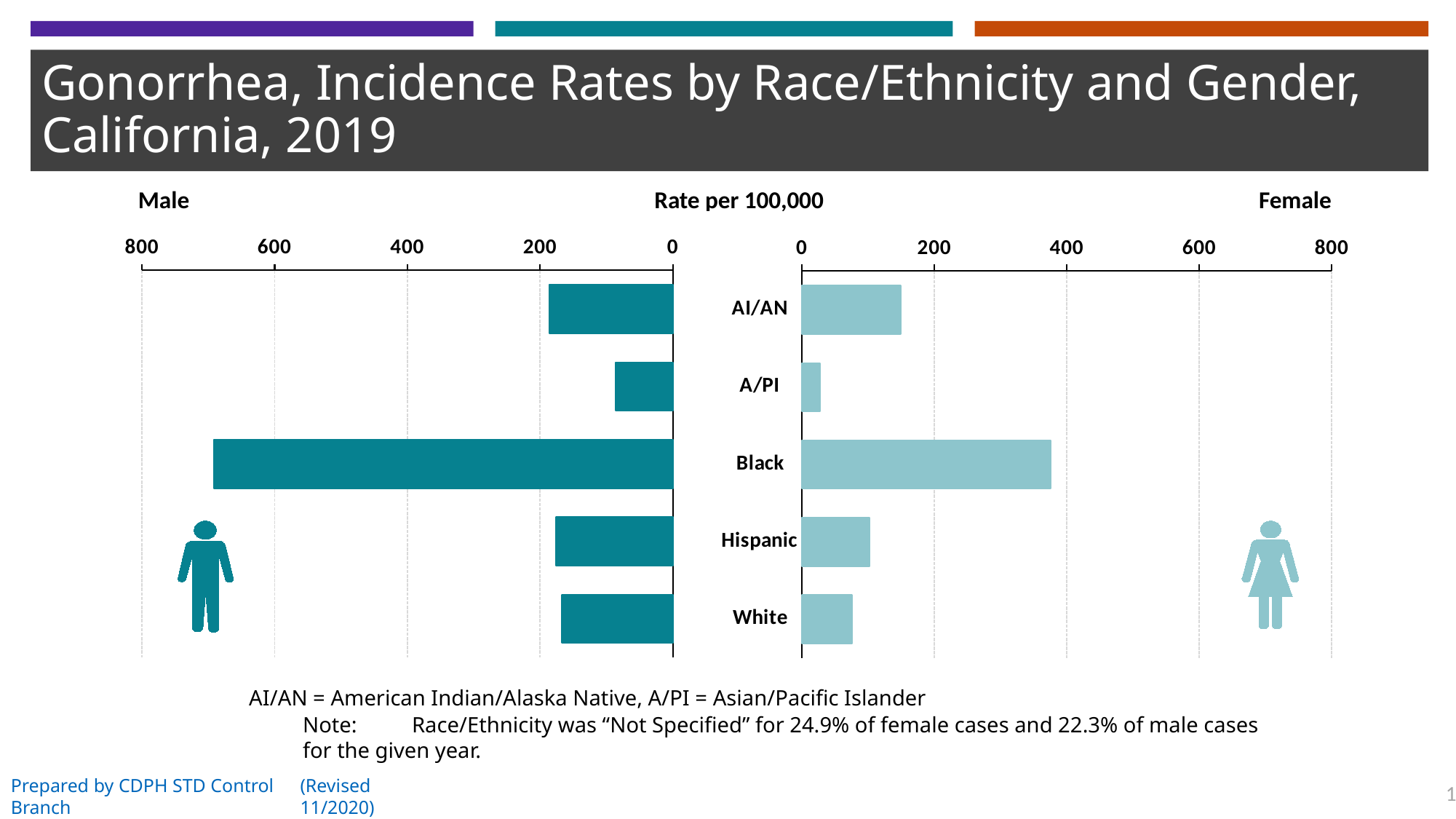
In the Male chart, which race/ethnicity has the highest gonorrhea incidence rate? Black How many race/ethnicity categories are shown in the chart? 5 In the Male chart, which race/ethnicity has the lowest gonorrhea incidence rate? A/PI In the Female chart, is the rate for Hispanic greater or less than 200? less Is the gonorrhea rate for Black males or Black females higher? Black males In the Female chart, which race/ethnicity has the highest gonorrhea incidence rate? Black What unit is the rate measured in, according to the axis label between the two charts? Rate per 100,000 In the Male chart, is the rate for Black greater or less than 600? greater In the Female chart, is the rate for Black greater or less than 200? greater In the Female chart, which race/ethnicity has the lowest gonorrhea incidence rate? A/PI What kind of chart is used on this slide? Bar chart Is the gonorrhea rate for White males or White females higher? White males